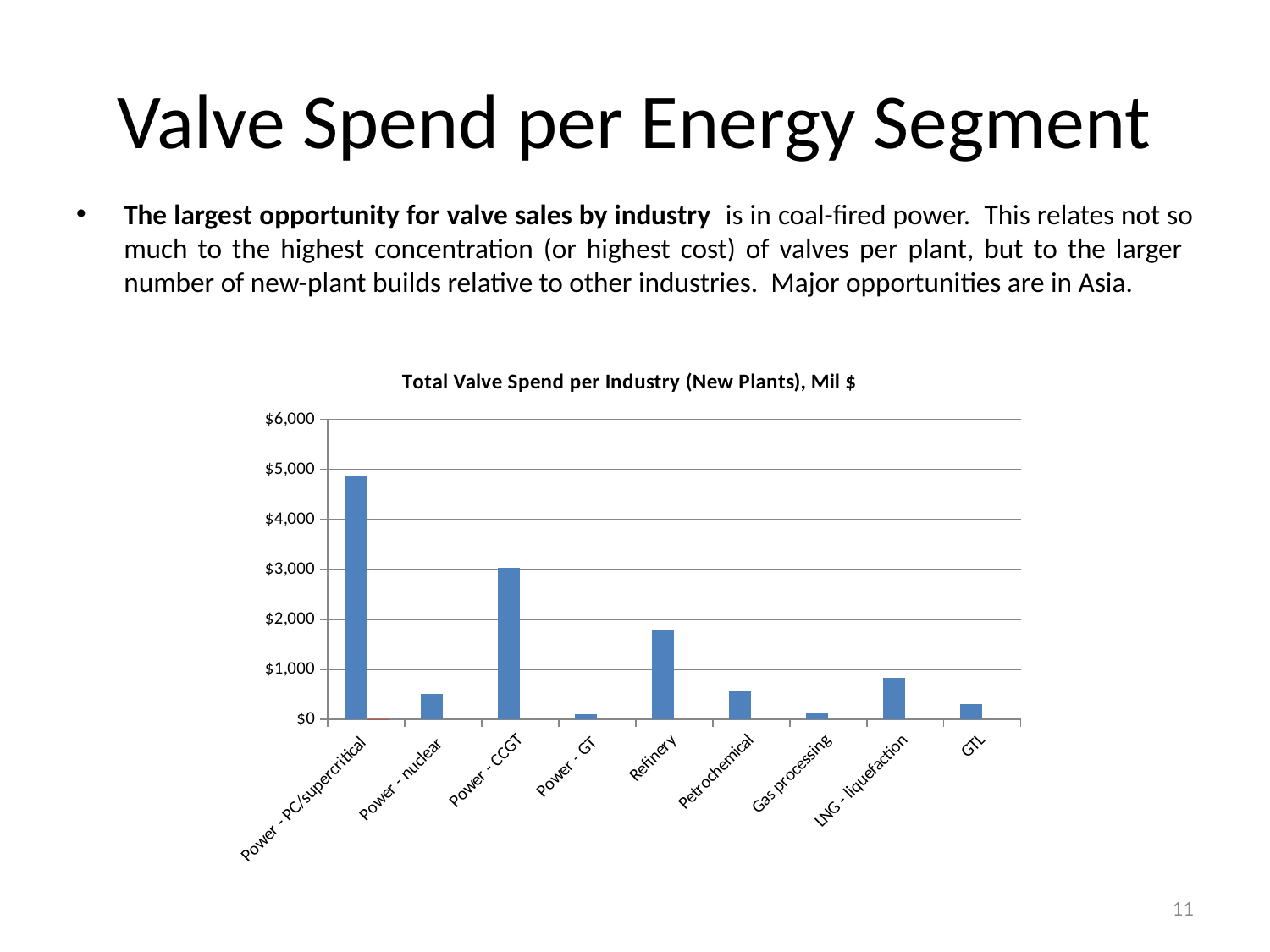
What is the highest value shown on the y axis of the chart? $6,000 Is the value for Power - PC/supercritical greater or less than $4,000? greater Which has a larger valve spend, LNG - liquefaction or Power - nuclear? LNG - liquefaction Which has a larger valve spend, Power - CCGT or Refinery? Power - CCGT Is the value for Power - CCGT greater or less than $4,000? less How many industry categories are shown on the x axis of the chart? 9 Which industry has the highest total valve spend in the chart? Power - PC/supercritical What kind of chart is shown on the slide? bar chart Is the value for Refinery greater or less than $2,000? less What is the title of the chart? Total Valve Spend per Industry (New Plants), Mil $